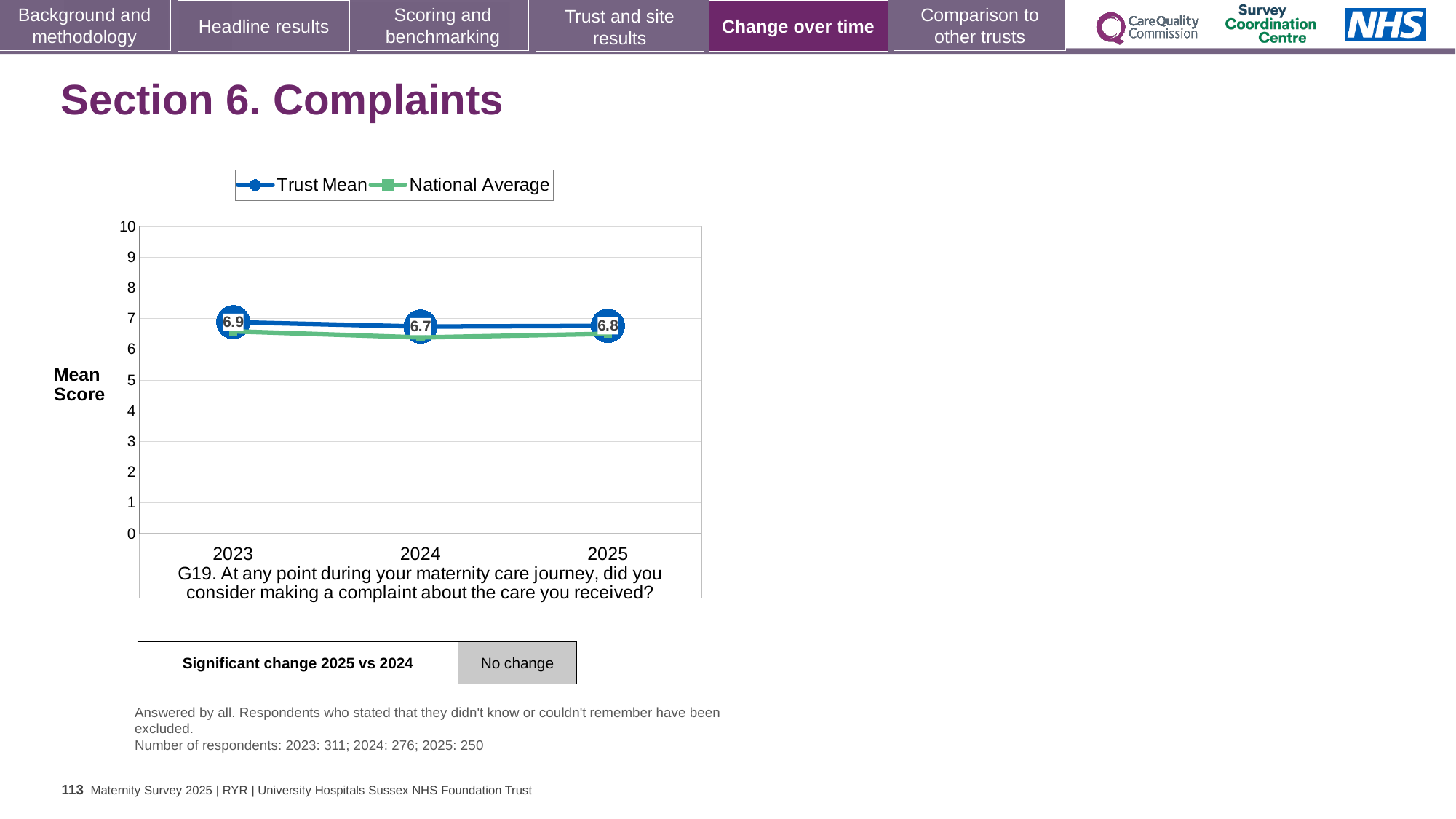
What is the difference between the Trust Mean scores for 2023 and 2024? 0.2 Which is larger, the Trust Mean score for 2023 or for 2025? 2023 What kind of chart is shown on the slide? line chart How many years are plotted on the x axis? 3 What is the Trust Mean score for 2023? 6.9 Is the National Average value for 2024 greater or less than 6? greater How many series does the legend list? 2 In which year is the Trust Mean score highest? 2023 Between 2023 and 2024, does the Trust Mean rise or fall? fall What is the Trust Mean score for 2025? 6.8 What is the Trust Mean score for 2024? 6.7 In which year is the Trust Mean score lowest? 2024